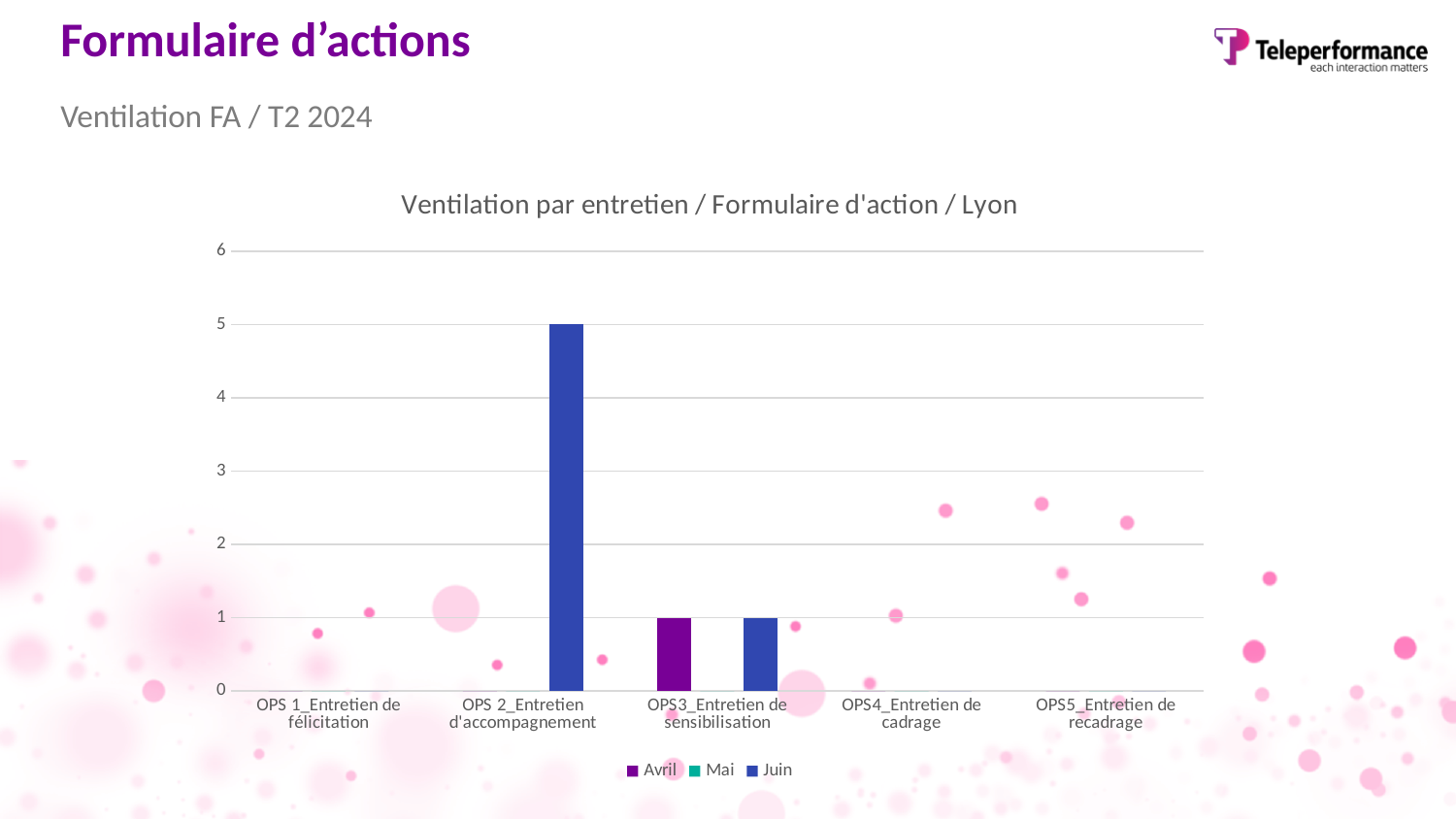
How many categories are shown on the x axis? 5 Which is larger: the Juin value for OPS 2_Entretien d'accompagnement or the Avril value for OPS3_Entretien de sensibilisation? Juin value for OPS 2_Entretien d'accompagnement Which series are listed in the legend? Avril, Mai, Juin What type of chart is shown on the slide? bar chart How many series does the legend list? 3 What is the Juin value for OPS3_Entretien de sensibilisation? 1 What is the title of the chart? Ventilation par entretien / Formulaire d'action / Lyon What is the Avril value for OPS3_Entretien de sensibilisation? 1 What is the Juin value for OPS 2_Entretien d'accompagnement? 5 What is the difference between the Juin value for OPS 2_Entretien d'accompagnement and the Juin value for OPS3_Entretien de sensibilisation? 4 Is the Juin value for OPS 2_Entretien d'accompagnement greater or less than 4? greater Which category has the highest Juin value? OPS 2_Entretien d'accompagnement